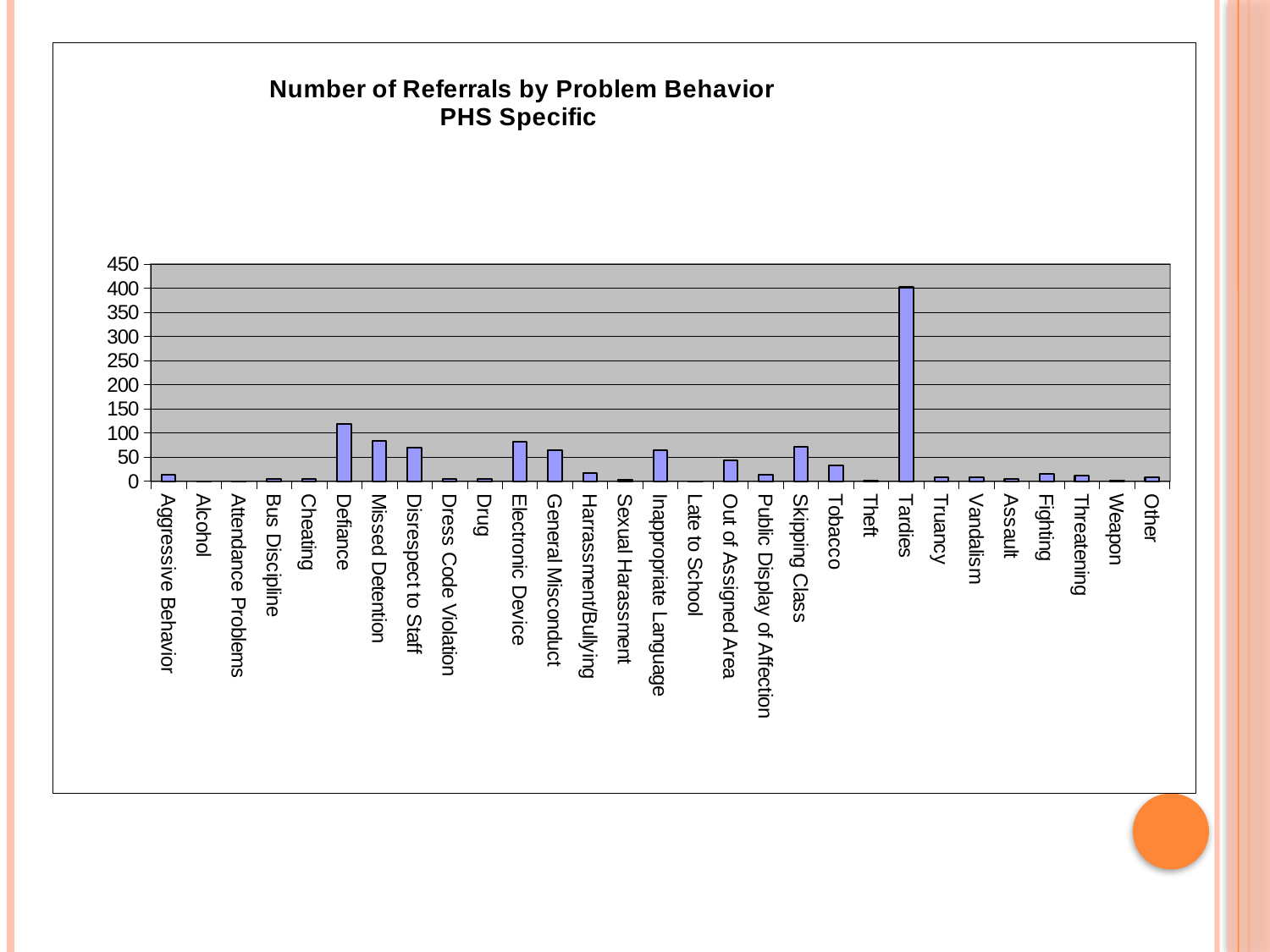
Is the value for Out of Assigned Area greater or less than 100? less Is the value for Defiance greater or less than 100? greater What is the title of the chart? Number of Referrals by Problem Behavior PHS Specific Which has more referrals, Defiance or Missed Detention? Defiance Is the value for Tardies greater or less than 350? greater How many problem behavior categories are shown on the x axis? 29 Which has more referrals, Skipping Class or Tobacco? Skipping Class What kind of chart is shown on the slide? bar chart Which has more referrals, Tardies or Defiance? Tardies Which problem behavior has the highest number of referrals? Tardies